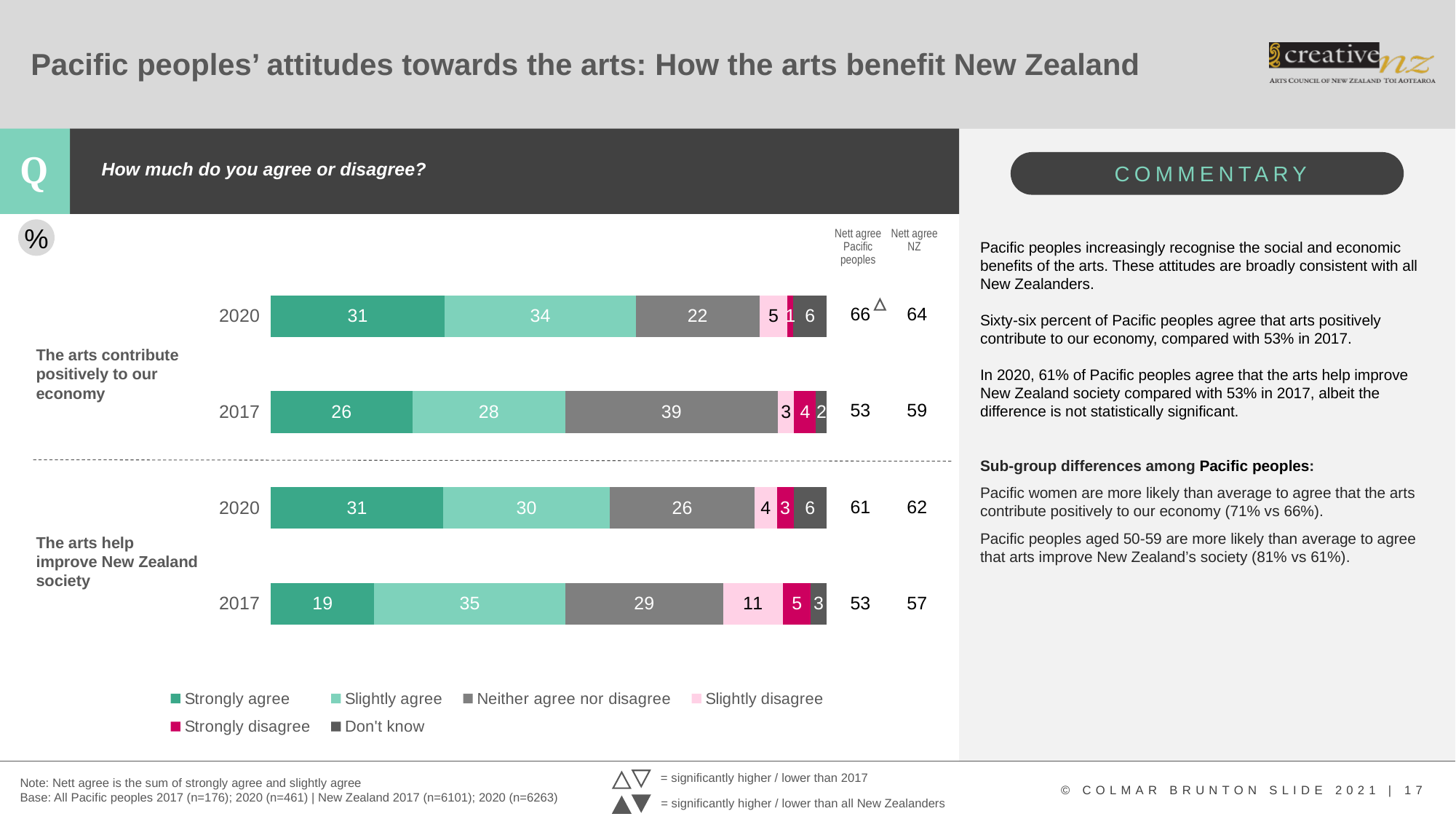
What is the 'Slightly disagree' value for 'The arts help improve New Zealand society' in 2017? 11 What is the Nett agree NZ figure for 'The arts contribute positively to our economy' in 2017? 59 Which bar has the lowest 'Strongly agree' value? The arts help improve New Zealand society, 2017 In 2017, what percentage neither agreed nor disagreed that the arts contribute positively to our economy? 39 Which has the larger 'Slightly agree' value in 2020: 'The arts contribute positively to our economy' or 'The arts help improve New Zealand society'? The arts contribute positively to our economy What percentage of Pacific peoples strongly agreed in 2020 that the arts contribute positively to our economy? 31 Which bar has the highest 'Neither agree nor disagree' value? The arts contribute positively to our economy, 2017 By how many percentage points did 'Strongly agree' for 'The arts help improve New Zealand society' increase from 2017 to 2020? 12 How many series does the legend list? 6 What is the Nett agree figure for Pacific peoples in 2020 for 'The arts help improve New Zealand society'? 61 How many bars are plotted in the chart? 4 What kind of chart is shown on the slide? Stacked bar chart